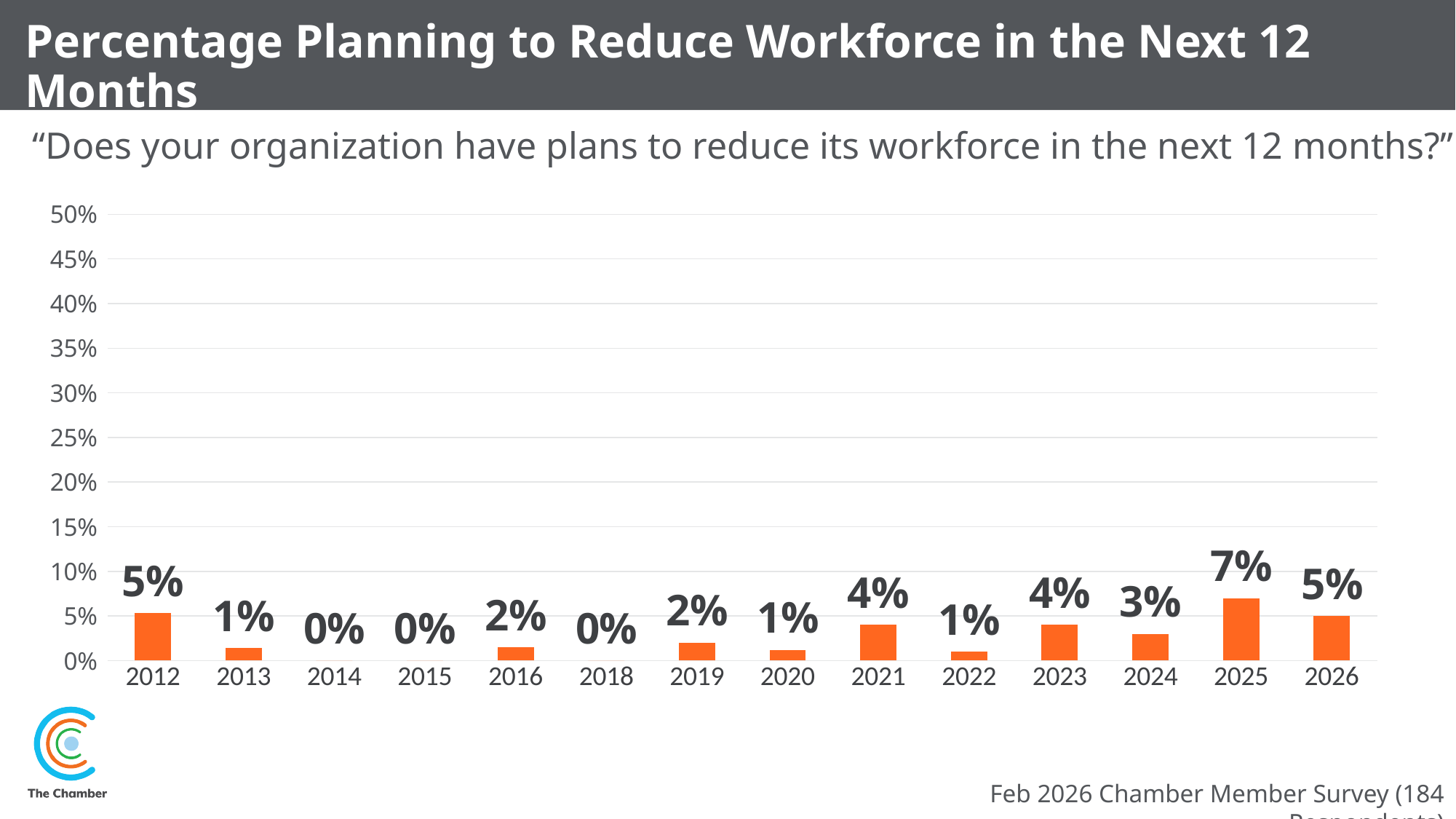
What is the difference between the 2025 value and the 2026 value? 2% Which year has the highest percentage planning to reduce workforce? 2025 How many years show a value of 0%? 3 What is the highest value shown on the y axis? 50% What percentage of organizations planned to reduce their workforce in 2025? 7% What is the value shown for 2012? 5% Is the value for 2025 greater or less than 10%? less Which is larger, the value for 2023 or the value for 2024? 2023 What colour are the bars in the chart? Orange How many years are shown on the x axis? 14 What kind of chart is shown on the slide? Bar chart What is the value shown for 2021? 4%